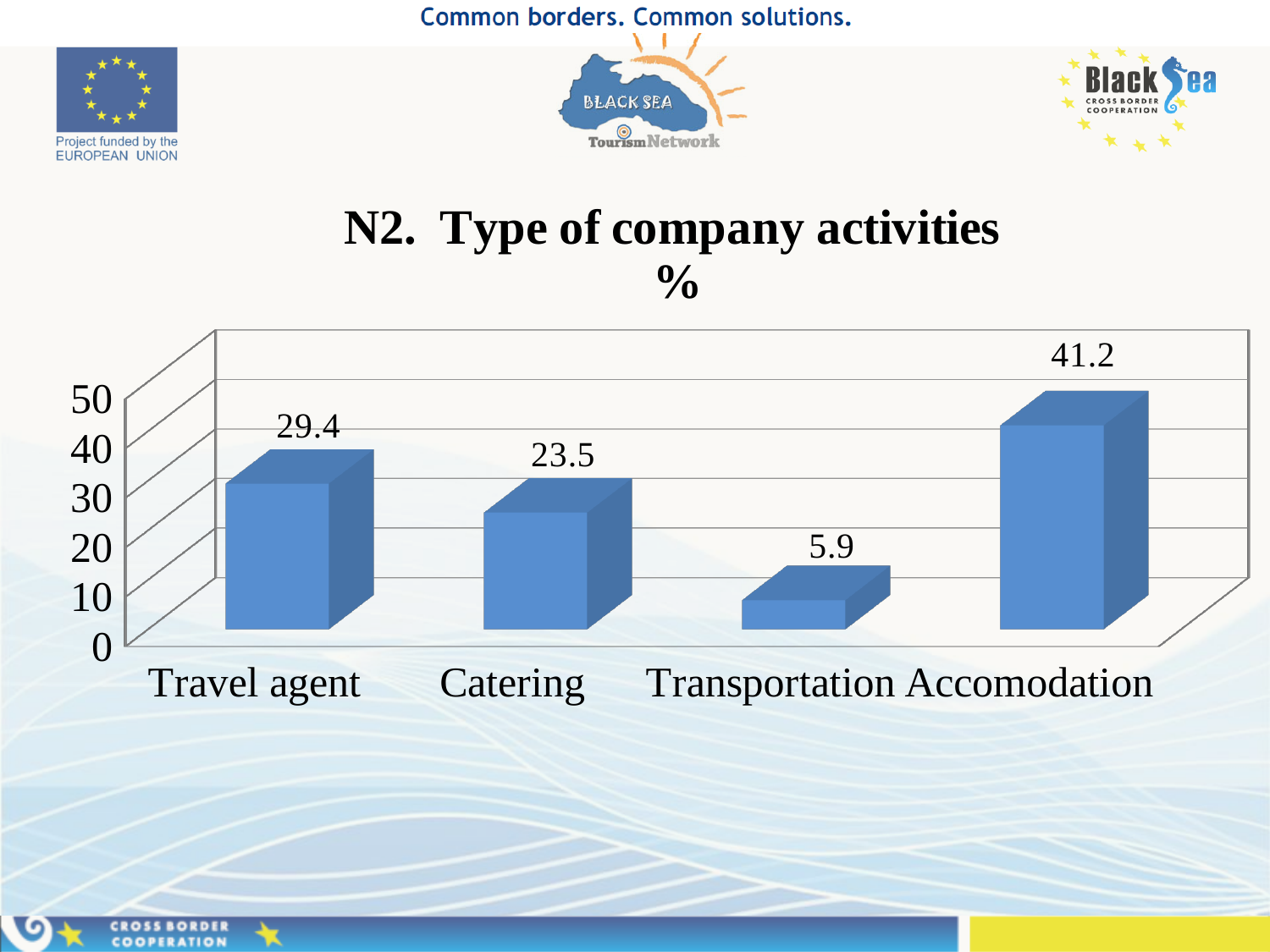
What is the value for Transportation? 5.9 What is the difference between the values for Accomodation and Travel agent? 11.8 What is the difference between the values for Travel agent and Catering? 5.9 Which category has the highest value? Accomodation How many categories are shown on the x axis? 4 What is the value for Catering? 23.5 Which is larger, the value for Catering or the value for Transportation? Catering What kind of chart is shown on the slide? Bar chart What is the title of the chart? N2. Type of company activities % What is the value for Accomodation? 41.2 What is the value for Travel agent? 29.4 Which category has the lowest value? Transportation